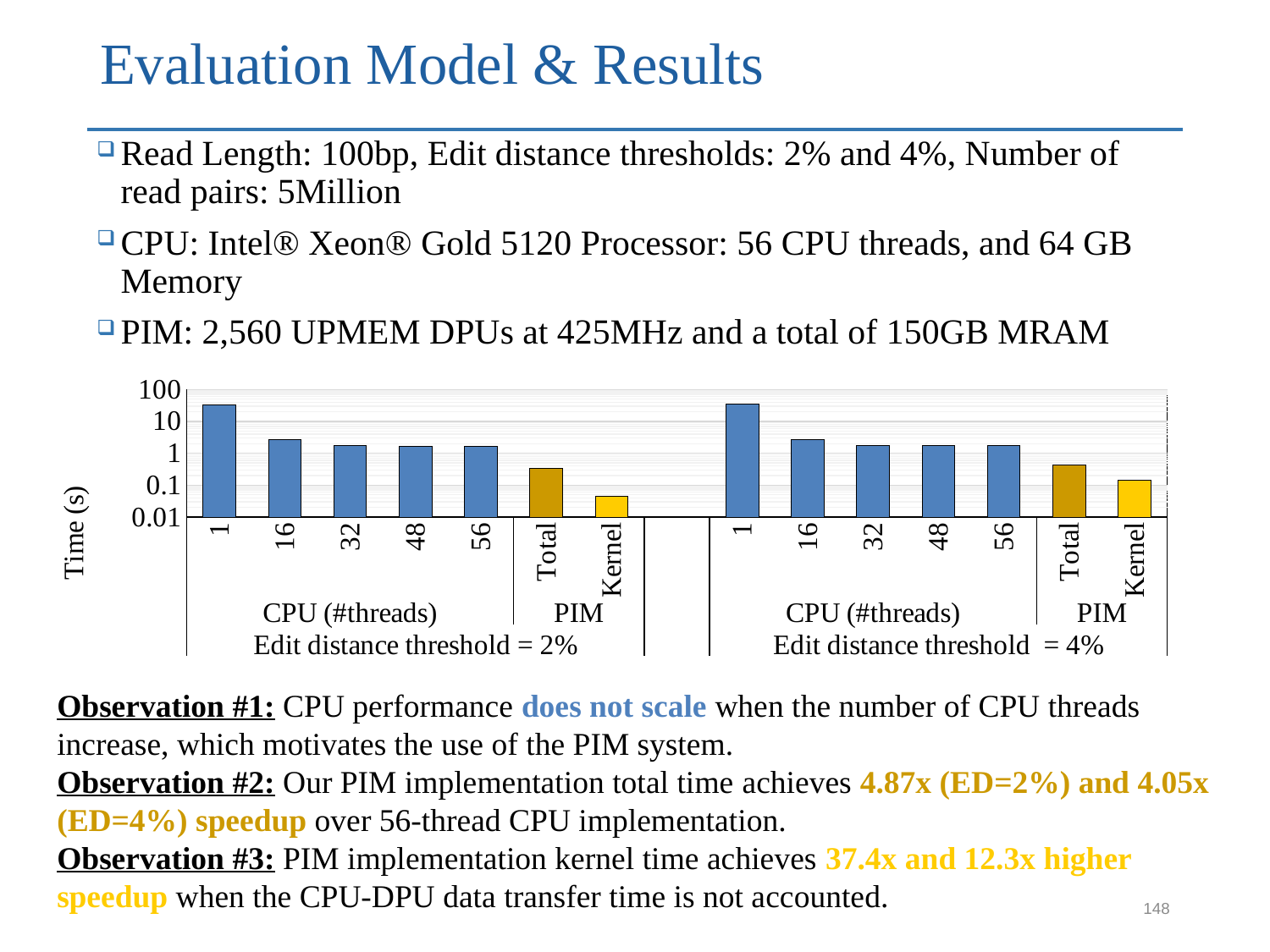
Is the time for CPU with 1 thread at edit distance threshold = 2% greater or less than 10? greater What kind of chart is shown on the slide? Bar chart Which is larger: the PIM Kernel time at edit distance threshold = 2% or at edit distance threshold = 4%? Edit distance threshold = 4% How many CPU thread counts are shown on the x-axis in each edit distance threshold group? 5 What is the label of the y-axis of the chart? Time (s) Is the time for PIM Kernel at edit distance threshold = 2% greater or less than 0.1? less How many bars are plotted in the 'Edit distance threshold = 2%' group? 7 In the 'Edit distance threshold = 2%' group, which category has the highest time? CPU with 1 thread In the 'Edit distance threshold = 2%' group, does the CPU time rise or fall from 1 thread to 16 threads? fall Is the time for CPU with 16 threads at edit distance threshold = 4% greater or less than 1? greater In the 'Edit distance threshold = 4%' group, which category has the lowest time? PIM Kernel